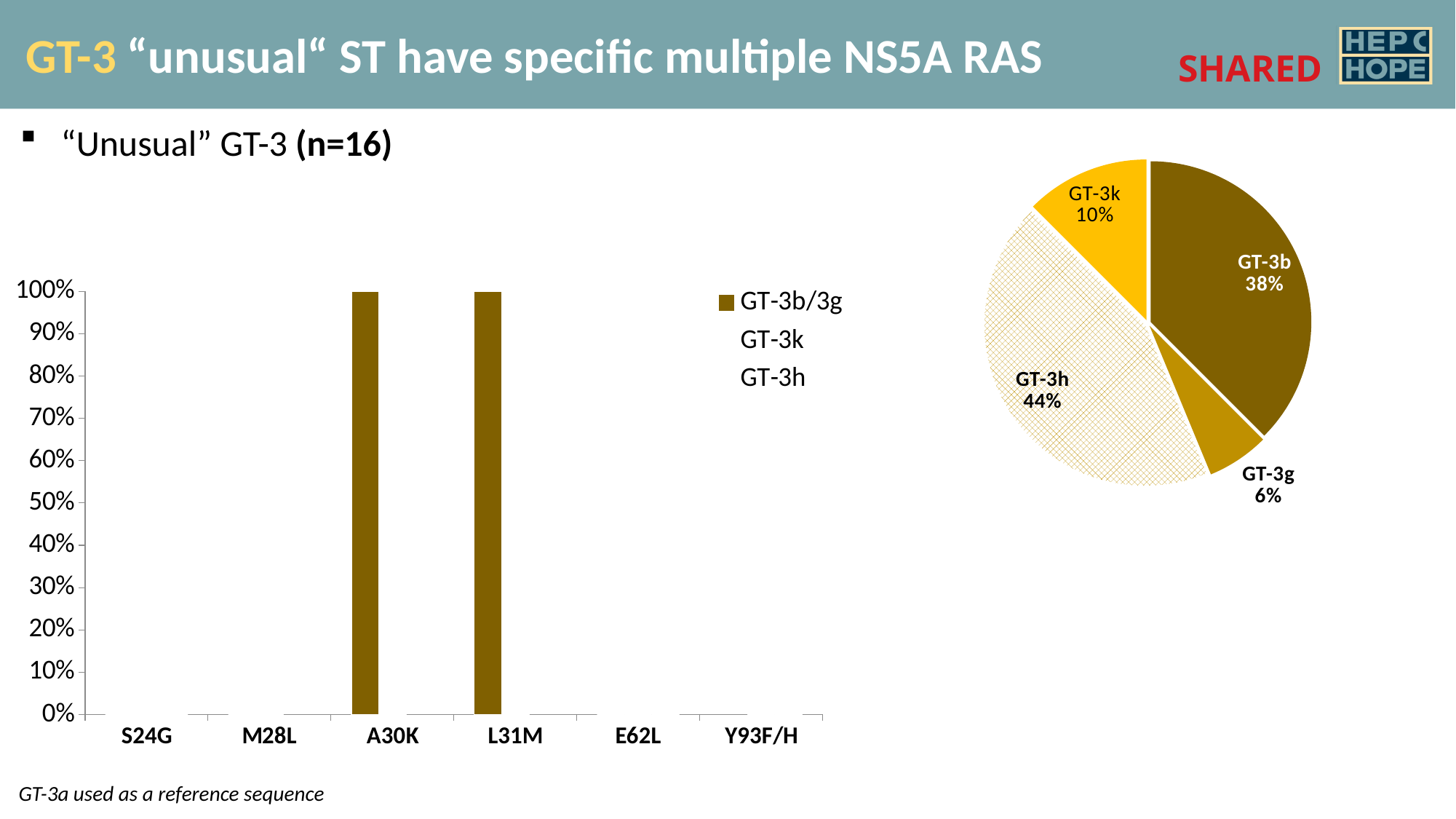
In the bar chart on the left, which is larger, the value for A30K or the value for E62L? A30K In the bar chart on the left, how many categories are shown on the x axis? 6 In the pie chart on the right, what share does GT-3b have? 38% In the pie chart on the right, what share does GT-3h have? 44% In the bar chart on the left, how many series does the legend list? 3 What kind of chart is the chart on the left of the slide? bar chart What kind of chart is the chart on the right of the slide? pie chart In the pie chart on the right, which slice is the smallest? GT-3g In the bar chart on the left, is the value for S24G greater or less than 50%? less In the pie chart on the right, what is the difference between the GT-3h share and the GT-3k share? 34% In the bar chart on the left, what is the value for L31M? 100% In the bar chart on the left, what is the value for A30K? 100%